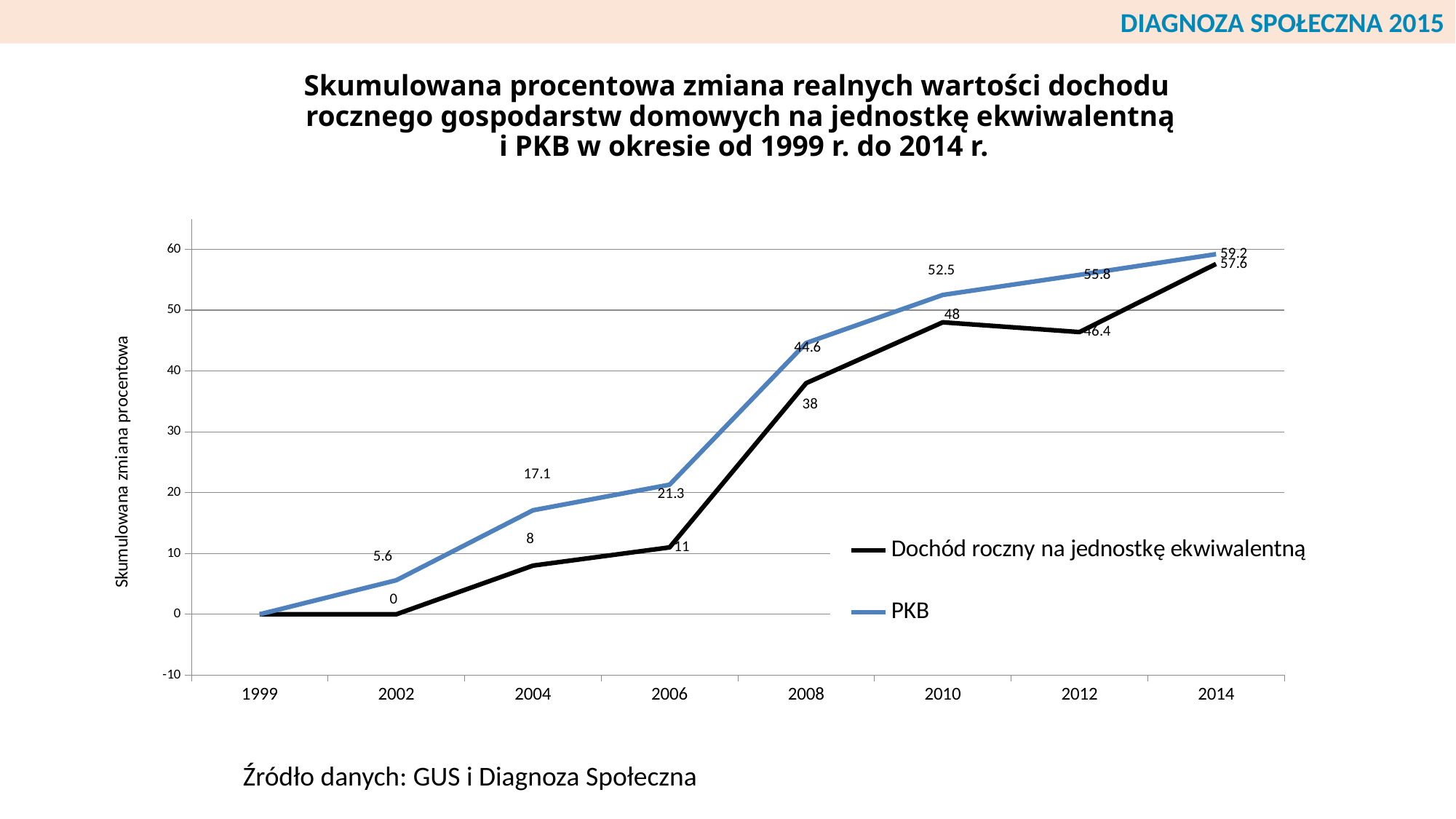
Is the value of Dochód roczny na jednostkę ekwiwalentną in 2008 greater or less than 40? less What is the value of Dochód roczny na jednostkę ekwiwalentną in 2010? 48 How many series does the legend list? 2 Which colour is used for the PKB line? blue How many years are shown on the x axis? 8 What is the value of PKB in 2008? 44.6 What kind of chart is shown on the slide? line chart Which is larger in 2006, PKB or Dochód roczny na jednostkę ekwiwalentną? PKB In which year does Dochód roczny na jednostkę ekwiwalentną reach its highest value? 2014 What is the value of PKB in 2014? 59.2 What is the difference between PKB and Dochód roczny na jednostkę ekwiwalentną in 2012? 9.4 Does the PKB series rise or fall from 1999 to 2014? rise